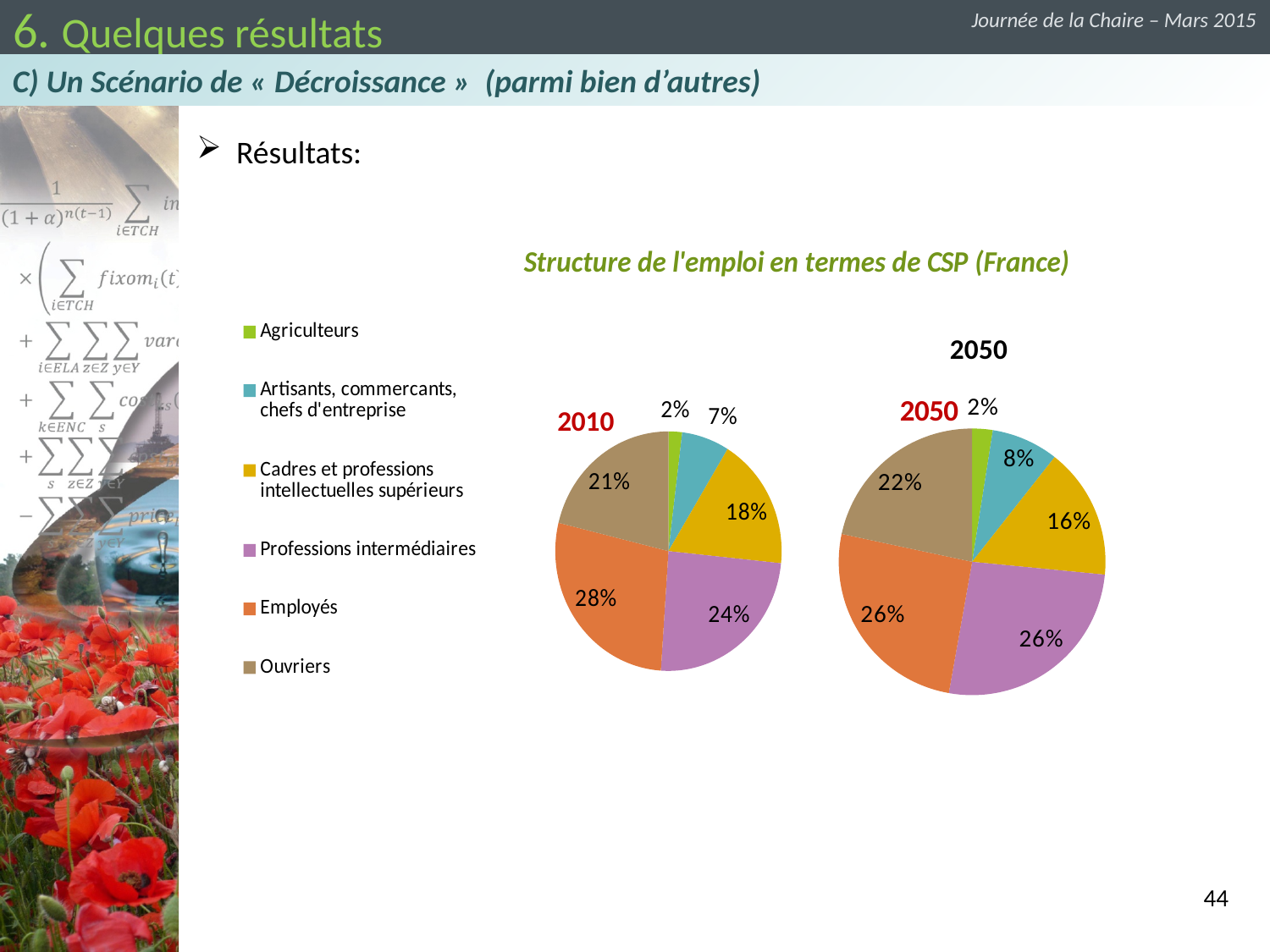
In the 2050 pie chart, what is the difference between the Ouvriers share and the Cadres et professions intellectuelles supérieures share? 6% How many categories does the legend list? 6 What is the title of the chart on the slide? Structure de l'emploi en termes de CSP (France) In the 2050 pie chart, what share is Artisans, commercants, chefs d'entreprise? 8% In the 2050 pie chart, what share of employment is Cadres et professions intellectuelles supérieures? 16% In the 2010 pie chart, what share of employment is Employés? 28% What kind of charts are shown on the slide? Pie charts Which is larger: the Cadres et professions intellectuelles supérieures share in 2010 or in 2050? 2010 In the 2010 pie chart, what share is Ouvriers? 21% In the 2010 pie chart, which category has the smallest share? Agriculteurs In the 2010 pie chart, which category has the largest share? Employés In the 2010 pie chart, what is the difference between the Employés share and the Ouvriers share? 7%